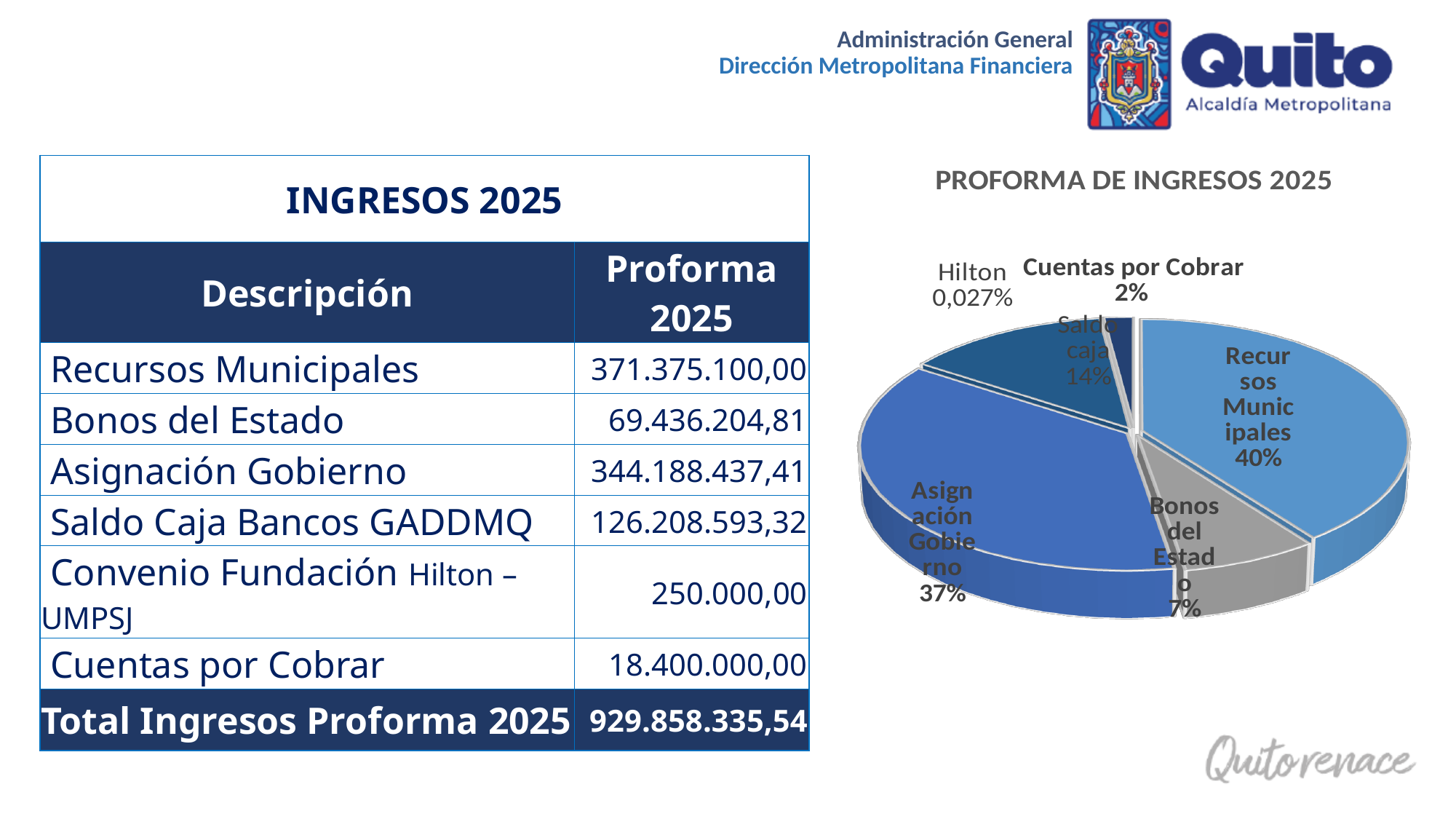
What percentage is shown for Hilton in the pie chart? 0,027% Which is larger in the pie chart, Saldo caja or Cuentas por Cobrar? Saldo caja What kind of chart is shown on the slide? Pie chart What is the difference in percentage points between Recursos Municipales and Asignación Gobierno? 3 What percentage is shown for Bonos del Estado in the pie chart? 7% How many slices does the pie chart have? 6 Which slice of the pie chart is the smallest? Hilton What share of the pie does Asignación Gobierno represent? 37% What percentage is shown for Saldo caja in the pie chart? 14% Which slice of the pie chart is the largest? Recursos Municipales What share of the pie does Recursos Municipales represent? 40% What is the title of the pie chart? PROFORMA DE INGRESOS 2025